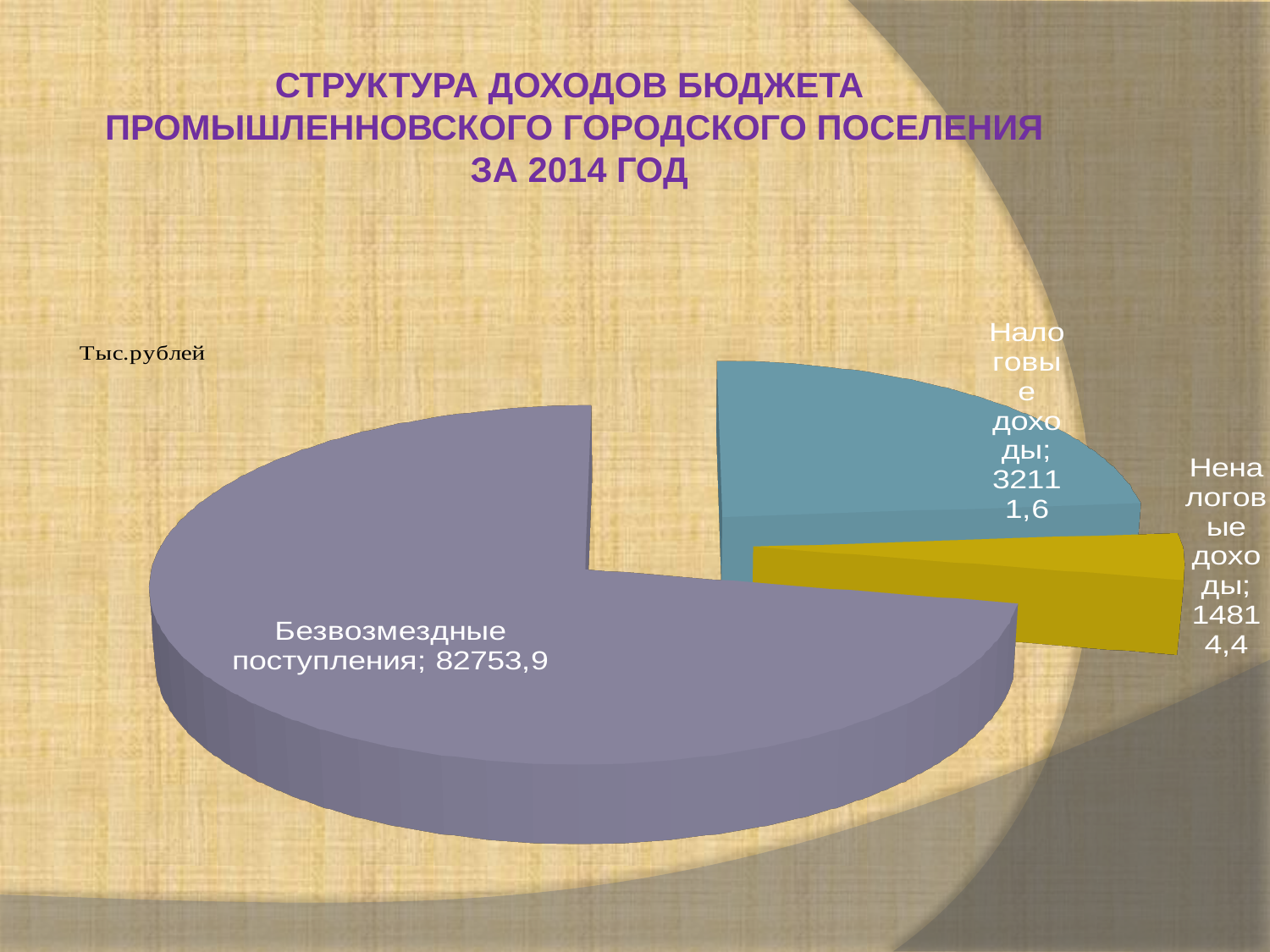
What is the value for Безвозмездные поступления? 82753,9 In what units are the values on the chart given? Тыс.рублей What is the difference between Налоговые доходы and Неналоговые доходы? 17297,2 What type of chart is shown on the slide? Pie chart What is the value for Налоговые доходы? 32111,6 What is the difference between Безвозмездные поступления and Налоговые доходы? 50642,3 Which category has the largest slice of the pie? Безвозмездные поступления How many slices does the pie chart have? 3 What is the value for Неналоговые доходы? 14814,4 What is the total of all three slices of the pie? 129679,9 Which category has the smallest slice of the pie? Неналоговые доходы Which is larger, Налоговые доходы or Неналоговые доходы? Налоговые доходы